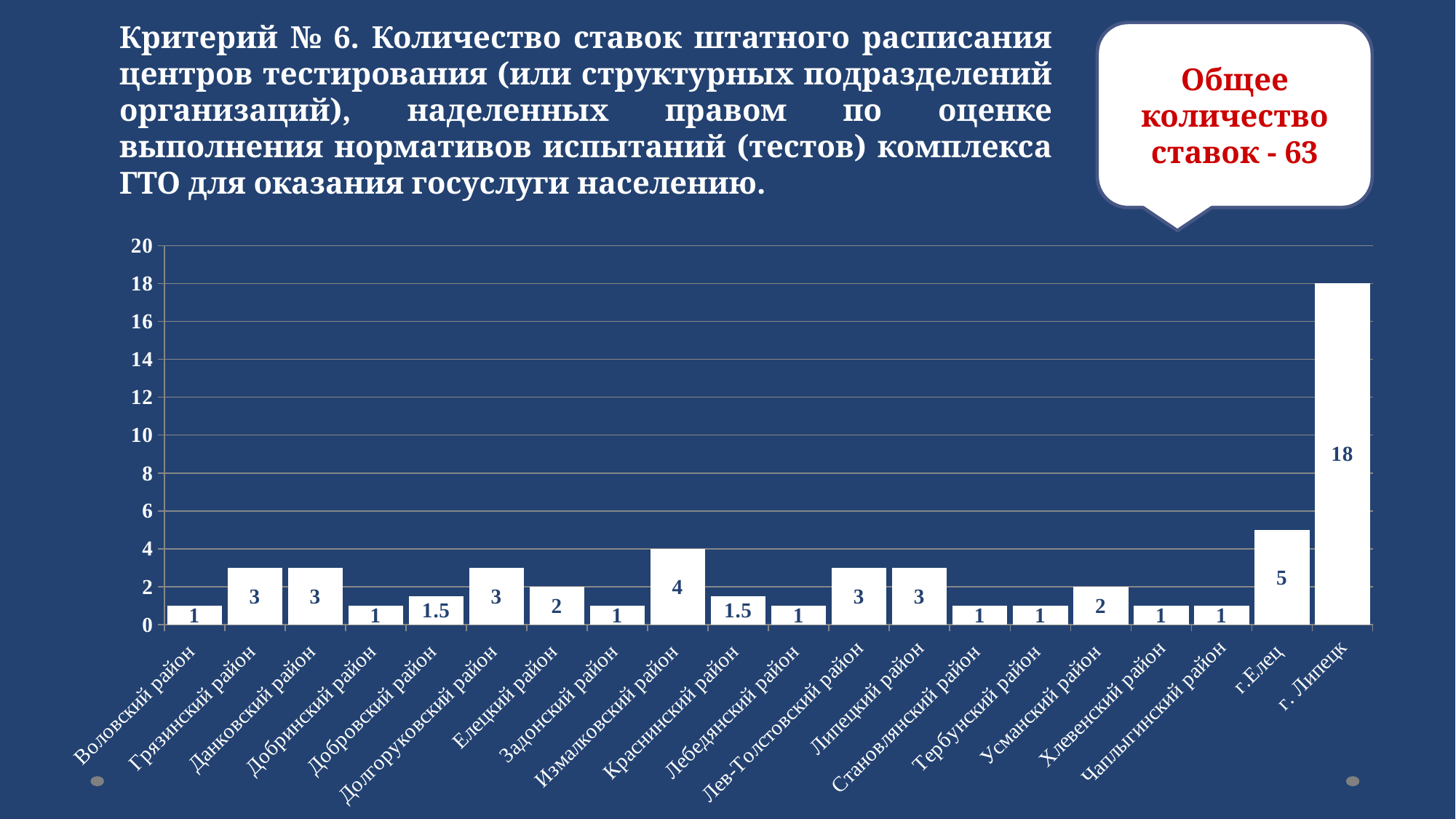
What is the value for Добровский район? 1.5 What is the value for Усманский район? 2 Which category has the highest value in the chart? г. Липецк What is the value for г. Липецк? 18 How many categories (districts and cities) are shown on the x axis of the chart? 20 Which is larger, the value for г.Елец or the value for Измалковский район? г.Елец What total number of positions (ставок) is stated in the callout box on the slide? 63 What is the value for г.Елец? 5 What type of chart is shown on the slide? bar chart Is the value for г. Липецк greater or less than 10? greater What is the value for Измалковский район? 4 What is the difference between the values for г. Липецк and г.Елец? 13